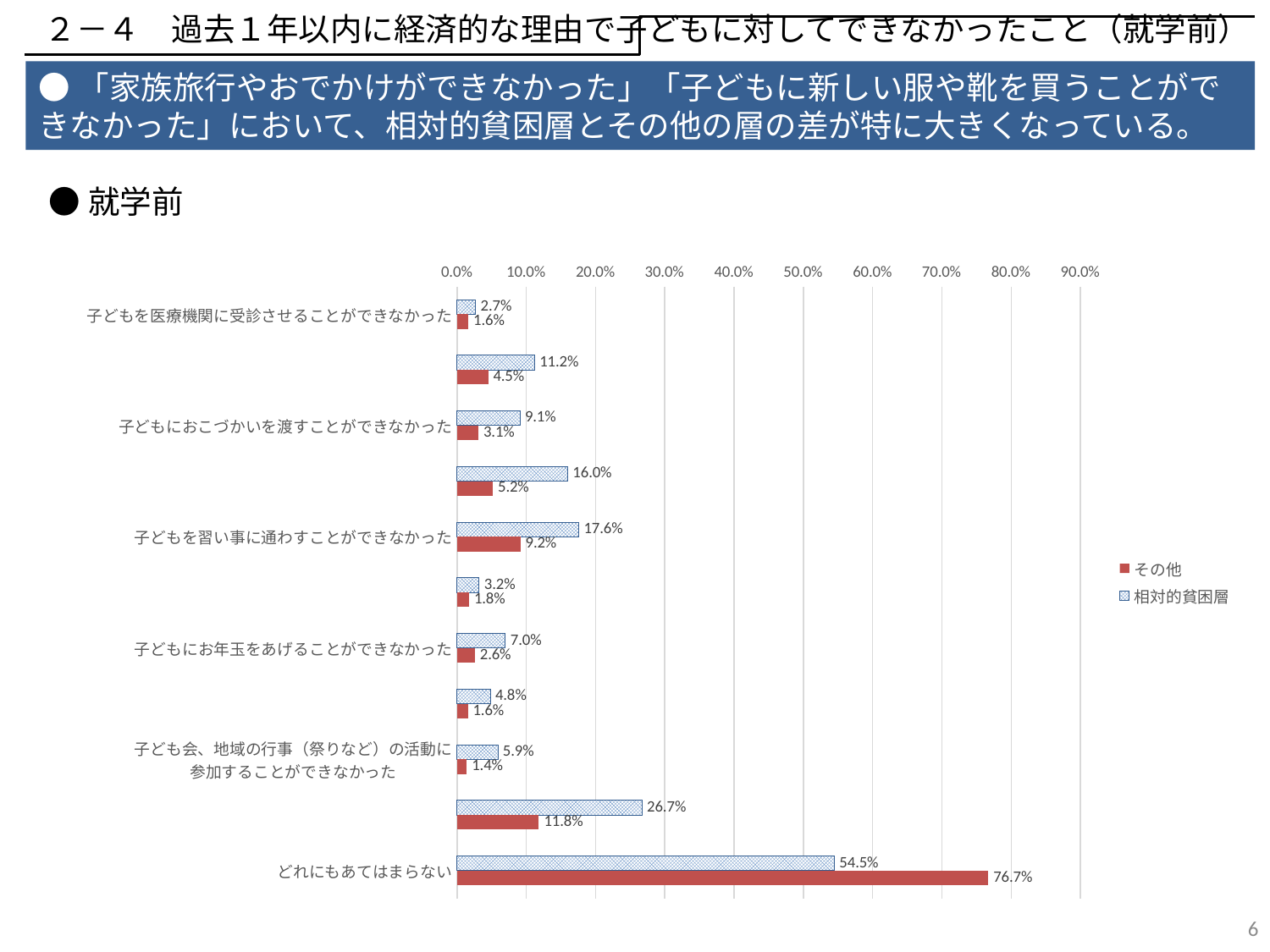
What are the two series named in the legend? その他 and 相対的貧困層 How many series does the legend list? 2 What is the value for その他 in the category どれにもあてはまらない? 76.7% What is the value for 相対的貧困層 in the category 子どもを医療機関に受診させることができなかった? 2.7% Is the value for その他 in the category どれにもあてはまらない greater or less than 70.0%? greater What is the difference between the 相対的貧困層 and その他 values for 子どもにお年玉をあげることができなかった? 4.4% What is the value for 相対的貧困層 in the category 子どもを習い事に通わすことができなかった? 17.6% In the category どれにもあてはまらない, which series has the larger value, その他 or 相対的貧困層? その他 What is the value for その他 in the category 子どもにおこづかいを渡すことができなかった? 3.1% What is the difference between the 相対的貧困層 and その他 values for 子ども会、地域の行事（祭りなど）の活動に参加することができなかった? 4.5% Which category has the highest value for 相対的貧困層? どれにもあてはまらない What kind of chart is shown on the slide? bar chart